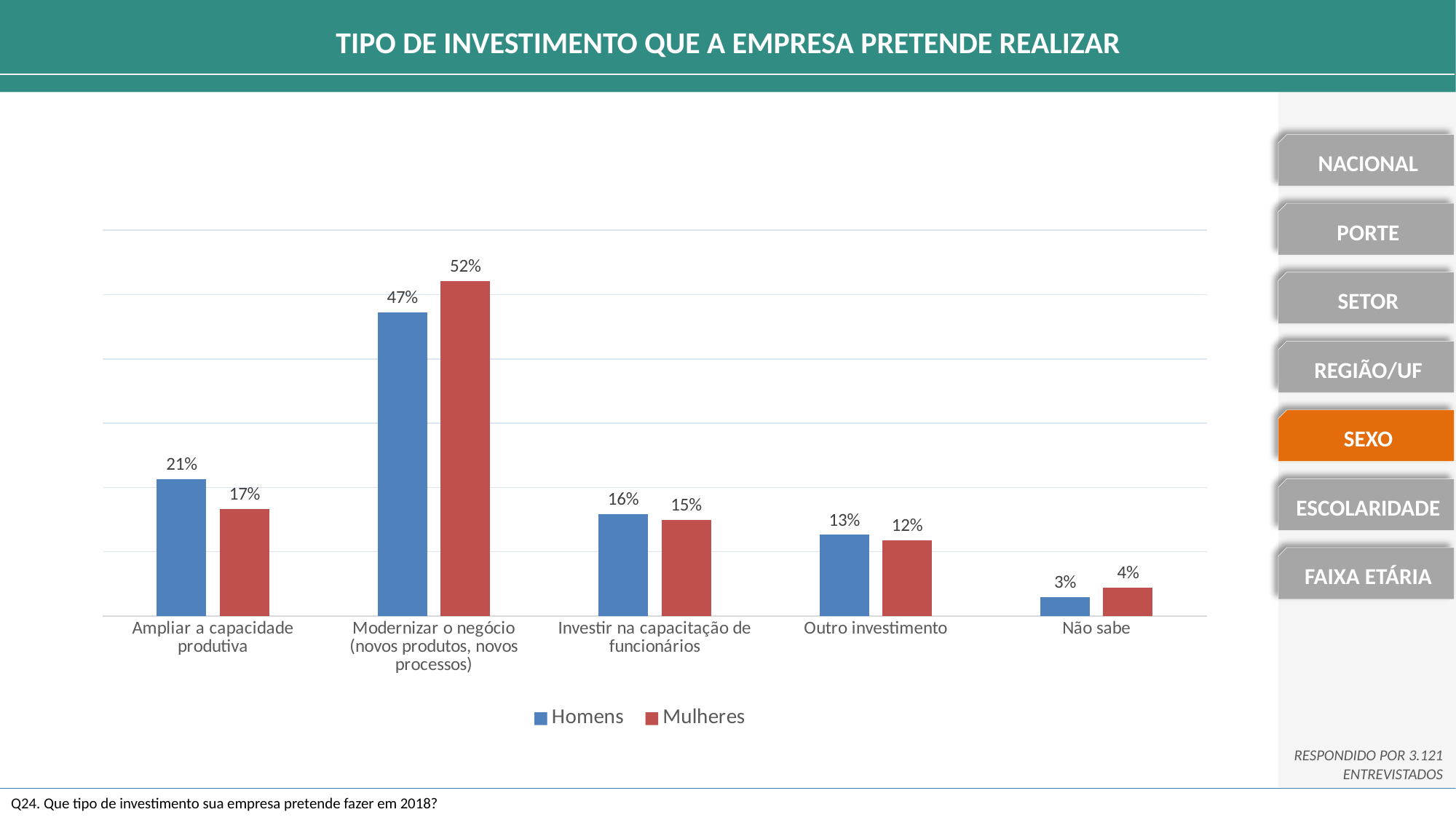
Which category has the lowest value for Homens? Não sabe What kind of chart is shown on the slide? Bar chart How many categories are shown on the x axis? 5 Which category has the highest value for Mulheres? Modernizar o negócio (novos produtos, novos processos) What is the value for Mulheres in the 'Não sabe' category? 4% What is the value for Mulheres in the 'Ampliar a capacidade produtiva' category? 17% What is the difference between the Mulheres and Homens values in the 'Modernizar o negócio (novos produtos, novos processos)' category? 5% Which is larger in the 'Ampliar a capacidade produtiva' category, Homens or Mulheres? Homens What is the value for Homens in the 'Modernizar o negócio (novos produtos, novos processos)' category? 47% How many series does the legend list? 2 What is the title of the chart? TIPO DE INVESTIMENTO QUE A EMPRESA PRETENDE REALIZAR What is the value for Homens in the 'Outro investimento' category? 13%